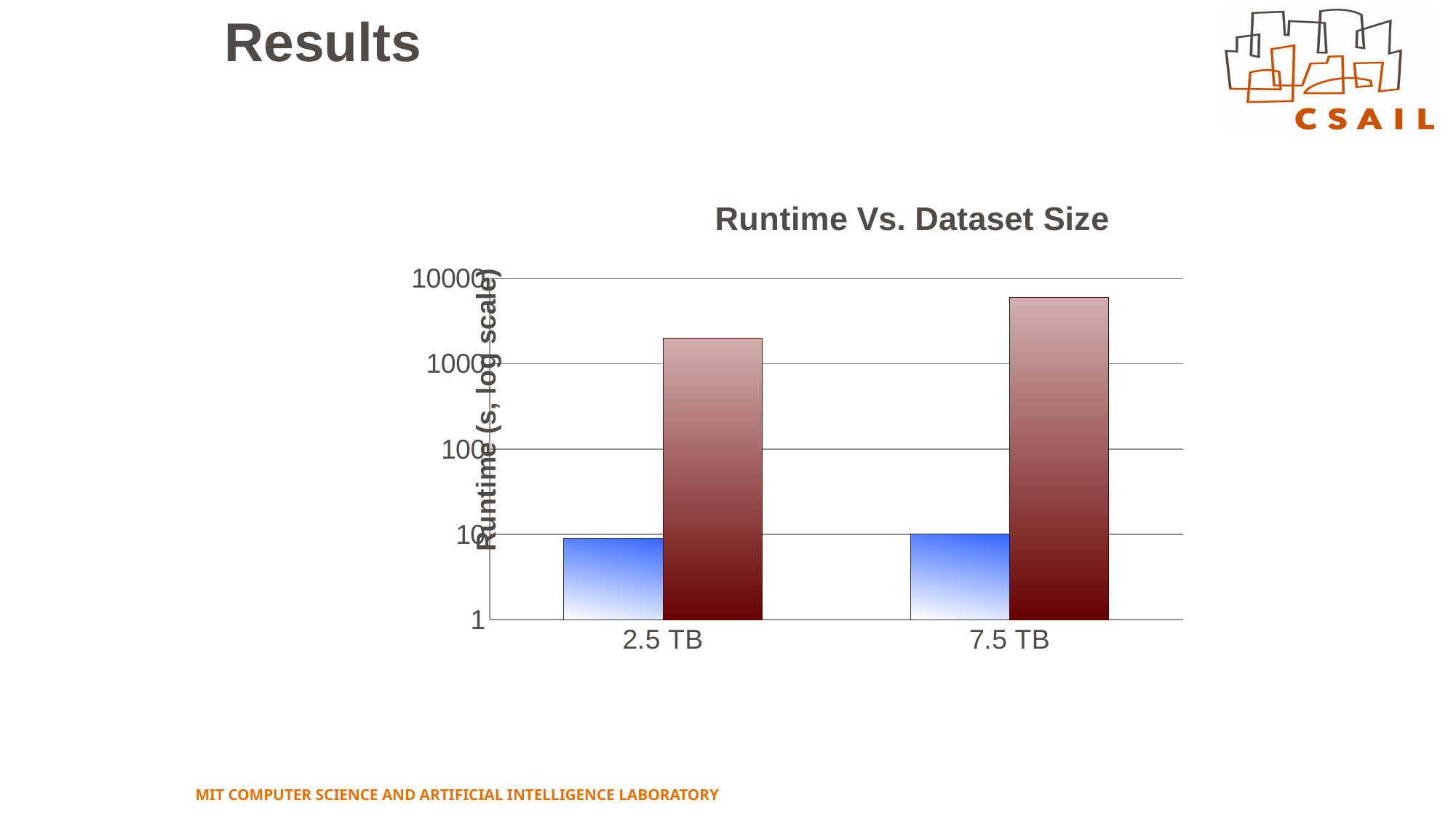
How many dataset size categories are shown on the x axis? 2 Do the dark red bars rise or fall from 2.5 TB to 7.5 TB? rise What is the label of the y axis? Runtime (s, log scale) Is the value of the dark red bar for 7.5 TB greater or less than 1000? greater Is the value of the blue bar for 2.5 TB greater or less than 100? less What is the title of the chart? Runtime Vs. Dataset Size How many bars are plotted for each dataset size category? 2 What type of chart is shown on the slide? bar chart Is the value of the dark red bar for 7.5 TB greater or less than 10000? less For 2.5 TB, which bar is larger, the blue bar or the dark red bar? the dark red bar For the dark red series, which dataset size has the larger value, 2.5 TB or 7.5 TB? 7.5 TB